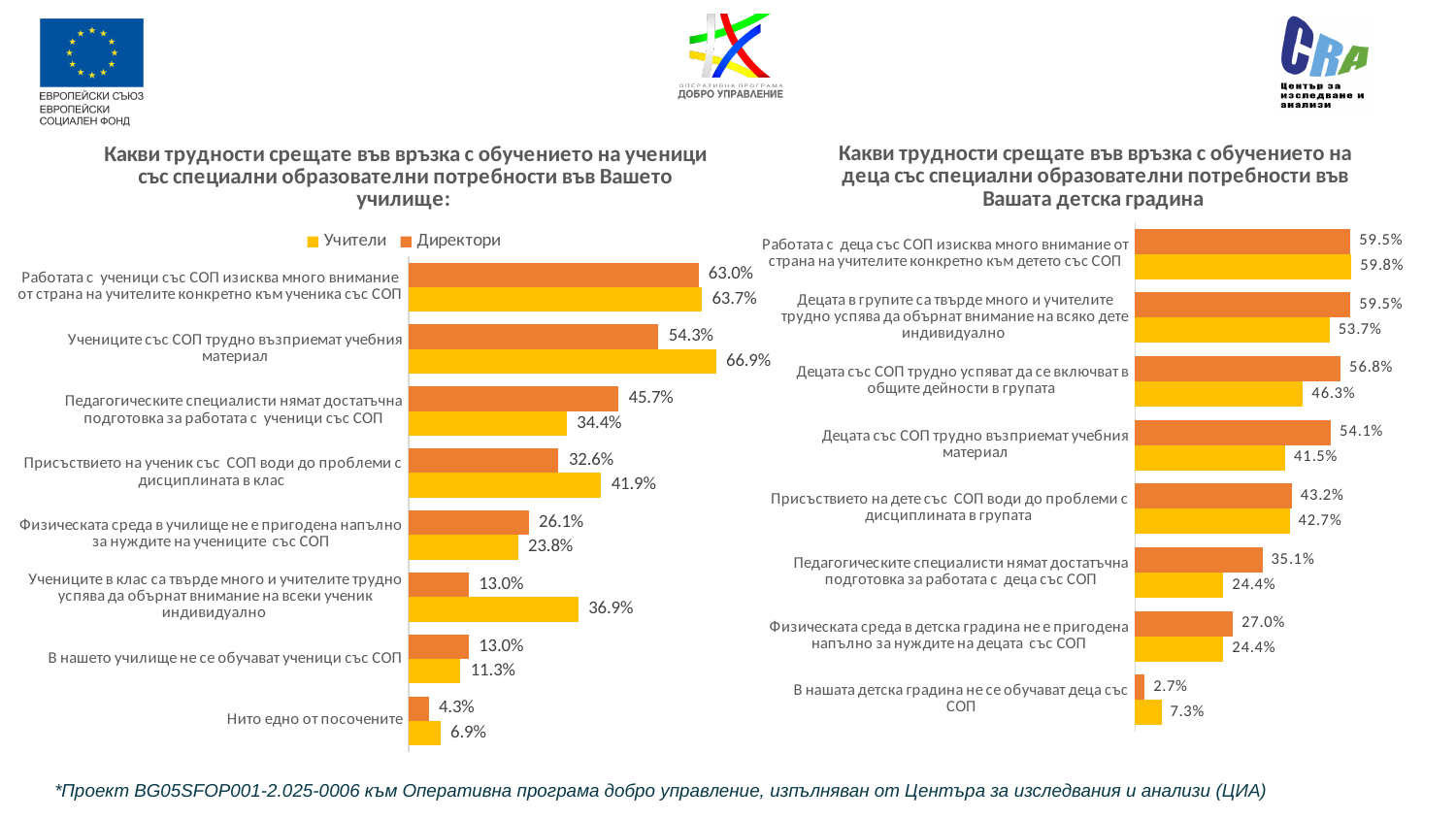
On the left chart (about schools), which colour represents Директори in the legend? Orange What type of chart is the right chart (about kindergartens)? Bar chart How many series does the legend on the left chart (about schools) list? 2 On the right chart (about kindergartens), what is the value of the yellow bar for 'В нашата детска градина не се обучават деца със СОП'? 7.3% How many categories are shown on the left chart (about schools)? 8 On the right chart (about kindergartens), what is the difference between the orange and yellow bars for 'Педагогическите специалисти нямат достатъчна подготовка за работата с деца със СОП'? 10.7 percentage points On the right chart (about kindergartens), what is the value of the orange bar for 'Децата със СОП трудно успяват да се включват в общите дейности в групата'? 56.8% On the left chart (about schools), which is larger for 'Присъствието на ученик със СОП води до проблеми с дисциплината в клас': Учители or Директори? Учители On the left chart (about schools), what is the value for Учители for 'Учениците със СОП трудно възприемат учебния материал'? 66.9% On the left chart (about schools), what is the difference between the Учители and Директори values for 'Учениците в клас са твърде много и учителите трудно успява да обърнат внимание на всеки ученик индивидуално'? 23.9 percentage points On the left chart (about schools), what is the value for Директори for 'Педагогическите специалисти нямат достатъчна подготовка за работата с ученици със СОП'? 45.7% On the left chart (about schools), which category has the lowest value for Директори? Нито едно от посочените